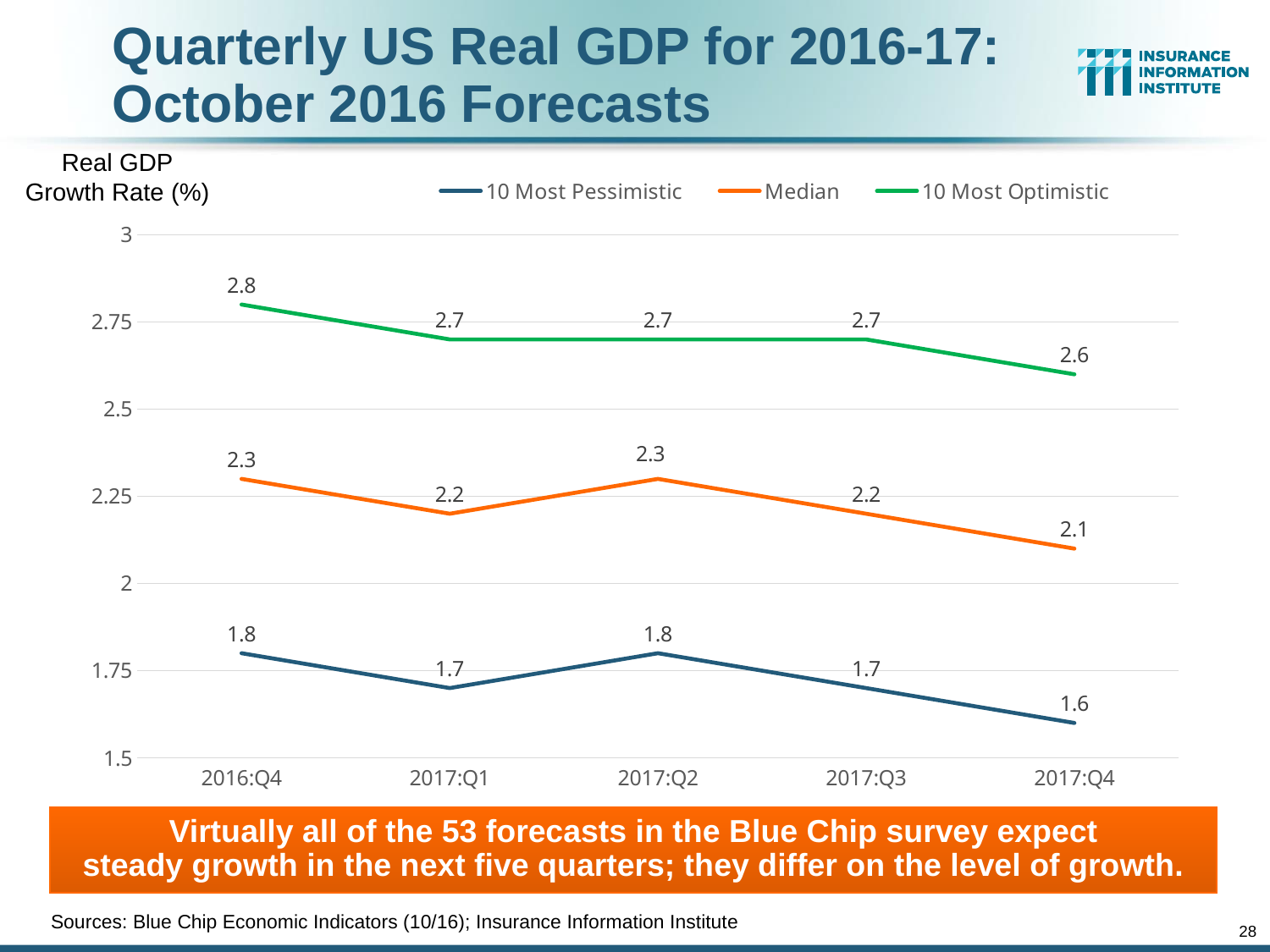
Does the 10 Most Optimistic forecast rise or fall from 2016:Q4 to 2017:Q4? Fall In which quarter is the Median forecast highest? 2016:Q4 and 2017:Q2 What is the 10 Most Optimistic forecast for 2016:Q4? 2.8 What is the difference between the 10 Most Optimistic and 10 Most Pessimistic forecasts for 2017:Q4? 1.0 What is the Median forecast for 2017:Q2? 2.3 How many quarters are shown on the x axis? 5 Which is larger, the Median forecast for 2017:Q1 or for 2017:Q2? 2017:Q2 What is the 10 Most Pessimistic forecast for 2017:Q4? 1.6 In which quarter is the 10 Most Optimistic forecast lowest? 2017:Q4 What kind of chart is shown? Line chart What is the difference between the Median forecast for 2016:Q4 and for 2017:Q4? 0.2 How many series does the legend list? 3